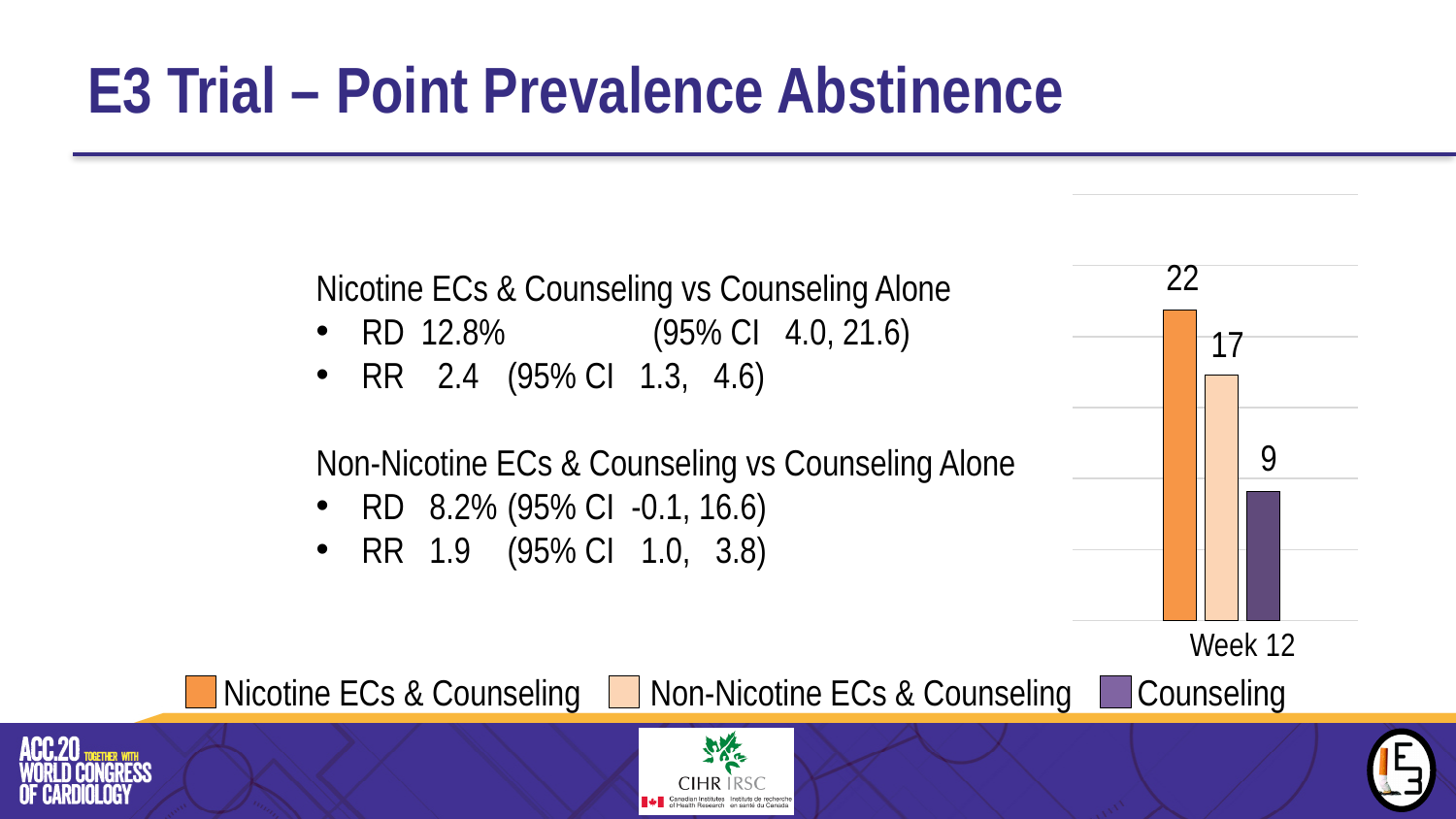
What is the value for Counseling at Week 12? 9 What is the difference between the Nicotine ECs & Counseling value and the Counseling value at Week 12? 13 What is the label of the category on the x axis? Week 12 How many categories are shown on the x axis? 1 What kind of chart is shown on the slide? Bar chart Which series has the highest value at Week 12? Nicotine ECs & Counseling What is the difference between the Nicotine ECs & Counseling value and the Non-Nicotine ECs & Counseling value at Week 12? 5 What is the value for Nicotine ECs & Counseling at Week 12? 22 What is the value for Non-Nicotine ECs & Counseling at Week 12? 17 Which is larger at Week 12: Non-Nicotine ECs & Counseling or Counseling? Non-Nicotine ECs & Counseling How many series does the legend list? 3 Which series has the lowest value at Week 12? Counseling